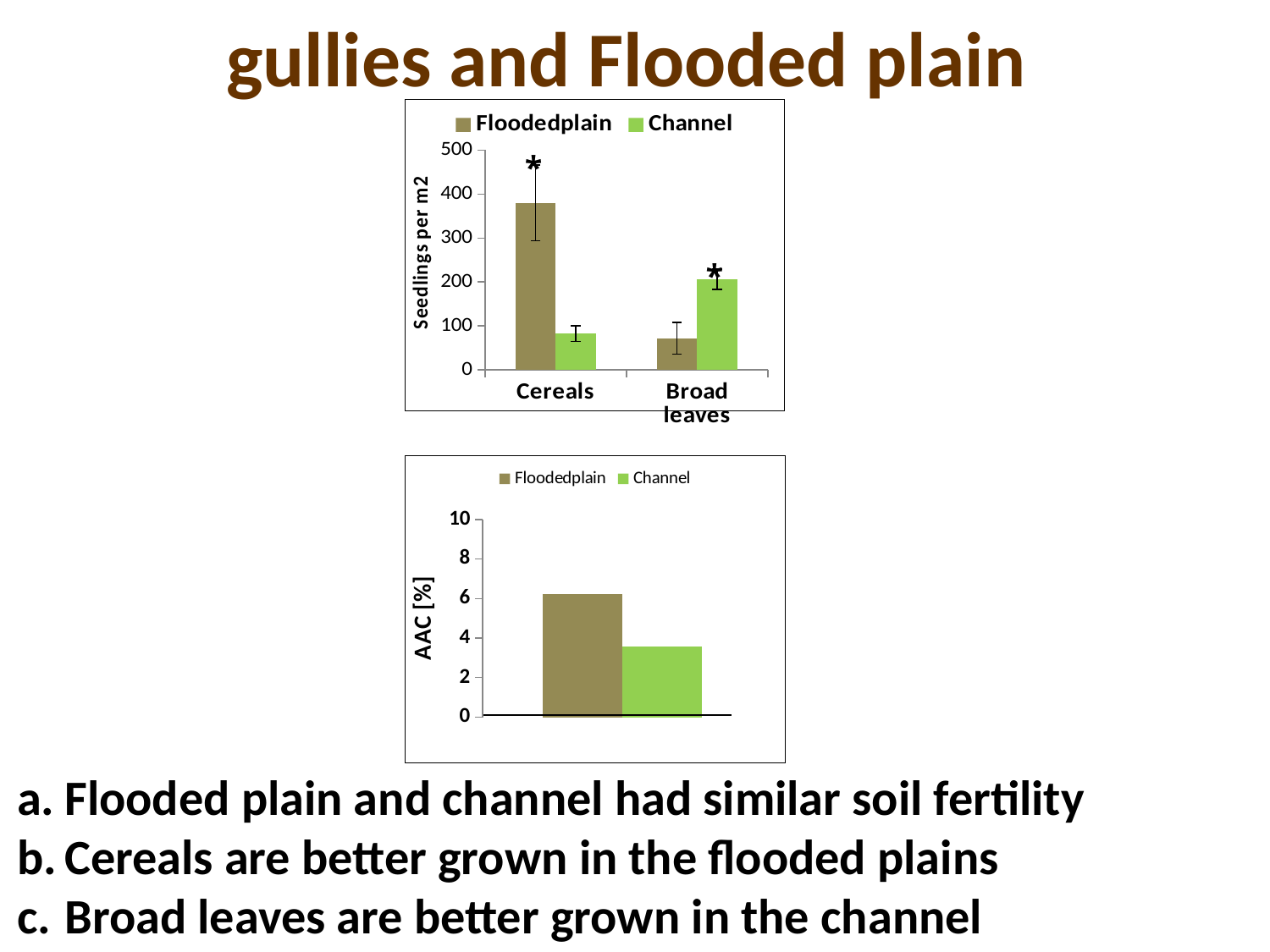
What is the y-axis title of the bottom chart? AAC [%] In the top chart (Seedlings per m2), is the Floodedplain value for Cereals greater or less than 300? greater In the top chart (Seedlings per m2), is the Channel value for Broad leaves greater or less than 100? greater What kind of chart is the top chart (Seedlings per m2)? bar chart In the bottom chart (AAC [%]), is the Channel value greater or less than 4? less In the top chart (Seedlings per m2), which series has the larger value for Cereals, Floodedplain or Channel? Floodedplain In the top chart (Seedlings per m2), which category has the highest Floodedplain value? Cereals How many categories are shown on the x axis of the top chart (Seedlings per m2)? 2 In the bottom chart (AAC [%]), which series has the larger value, Floodedplain or Channel? Floodedplain In the top chart (Seedlings per m2), which series has the larger value for Broad leaves, Floodedplain or Channel? Channel How many series does the legend of the top chart (Seedlings per m2) list? 2